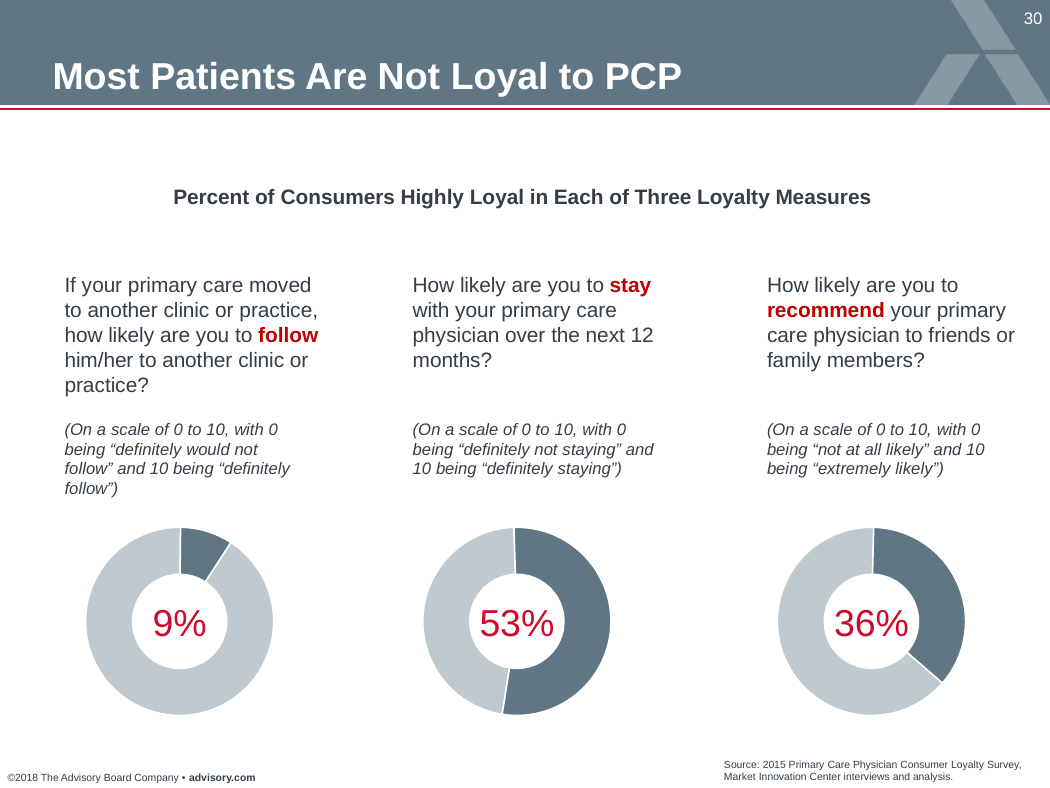
In the middle donut chart (stay), what share of the ring does the dark segment represent? 53% What is the difference in percentage points between the stay measure and the follow measure? 44 What is the title above the three donut charts? Percent of Consumers Highly Loyal in Each of Three Loyalty Measures In the left donut chart (follow), what percent of consumers are highly loyal? 9% Which of the three loyalty measures has the highest percent of highly loyal consumers? stay In the right donut chart (recommend), what percent of consumers are highly loyal? 36% Which is larger, the percent highly loyal for stay or for recommend? stay In the middle donut chart (stay), what percent of consumers are highly loyal? 53% Which of the three loyalty measures has the lowest percent of highly loyal consumers? follow How many donut charts are on the slide? 3 What kind of charts are shown on the slide? donut (pie) charts What is the difference in percentage points between the recommend measure and the follow measure? 27